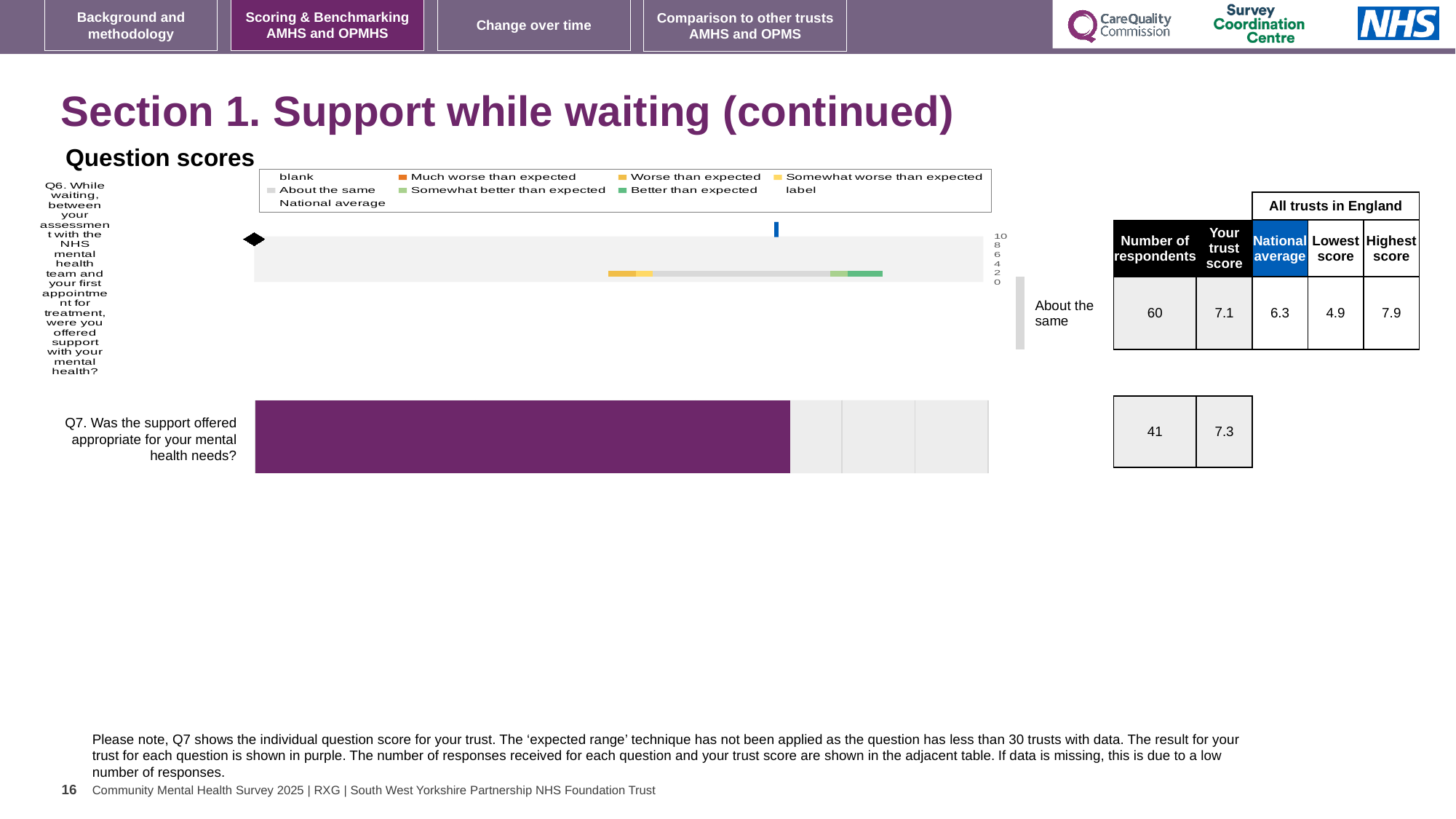
What is the trust score for Q6 shown in the table next to the chart? 7.1 How many respondents answered Q6? 60 What is the national average score for Q6? 6.3 What is the difference between the trust score and the national average for Q6? 0.8 What is the highest score among all trusts in England for Q6? 7.9 What category label is shown for Q6 in the expected range chart? About the same Which question has the higher trust score, Q6 or Q7? Q7 What kind of chart is used to show the question scores on this slide? Bar chart What is the difference between the highest and lowest scores among all trusts in England for Q6? 3.0 How many respondents answered Q7? 41 What is the trust score for Q7? 7.3 What is the lowest score among all trusts in England for Q6? 4.9